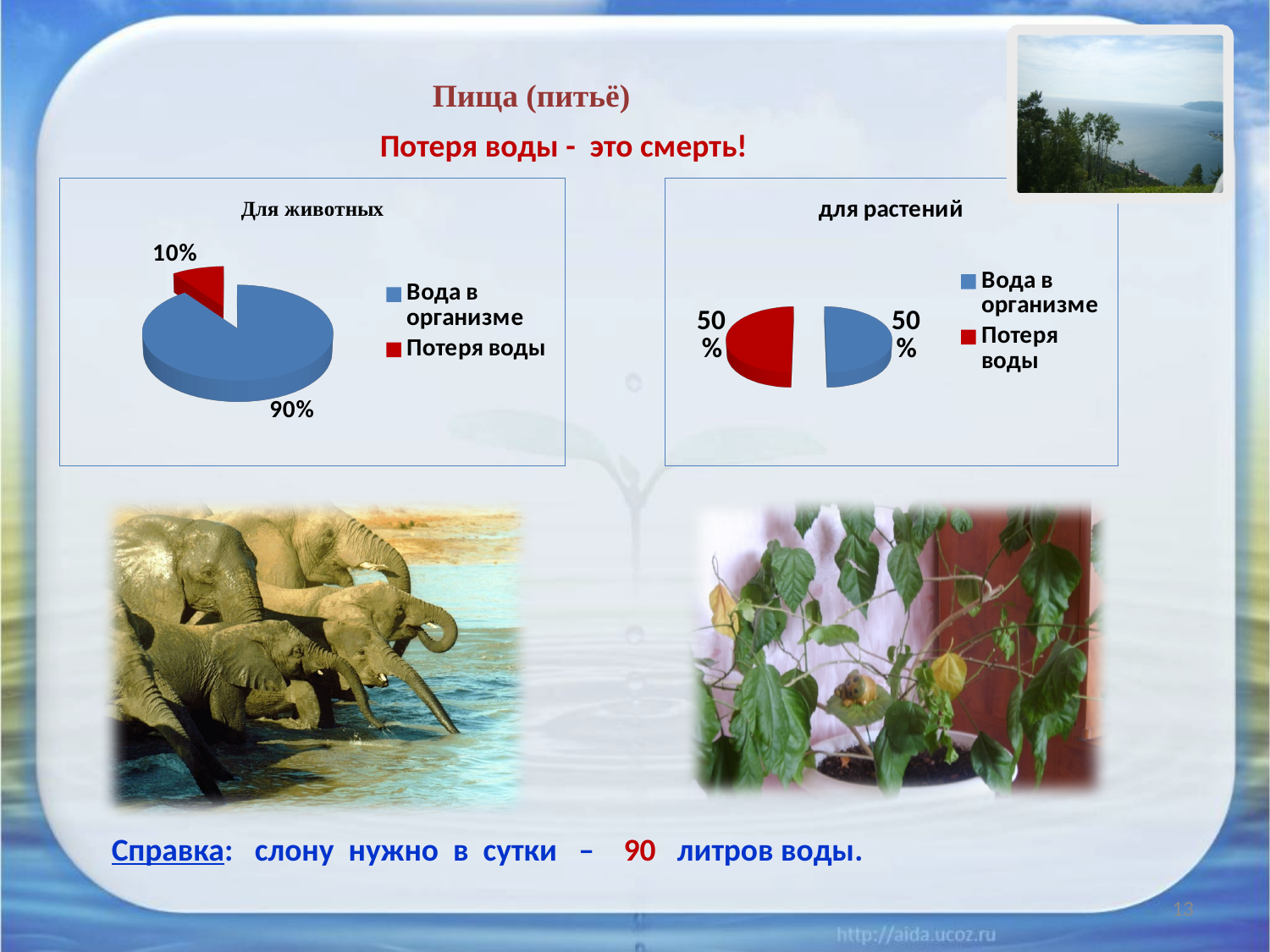
In the chart titled "Для животных", what share is labelled for "Потеря воды"? 10% In the chart titled "Для животных", which slice is the smallest? Потеря воды In the chart titled "Для животных", which colour represents "Потеря воды"? Red What is the title of the pie chart on the right side of the slide? для растений In the chart titled "Для животных", what share is labelled for "Вода в организме"? 90% In the chart titled "для растений", what share is labelled for "Вода в организме"? 50% How many entries does the legend of the chart titled "Для животных" list? 2 What kind of chart is the one titled "Для животных"? Pie chart How many slices does the chart titled "для растений" have? 2 In the chart titled "Для животных", which slice is the largest? Вода в организме In the chart titled "Для животных", what is the difference between the "Вода в организме" and "Потеря воды" shares? 80% In the chart titled "для растений", what share is labelled for "Потеря воды"? 50%